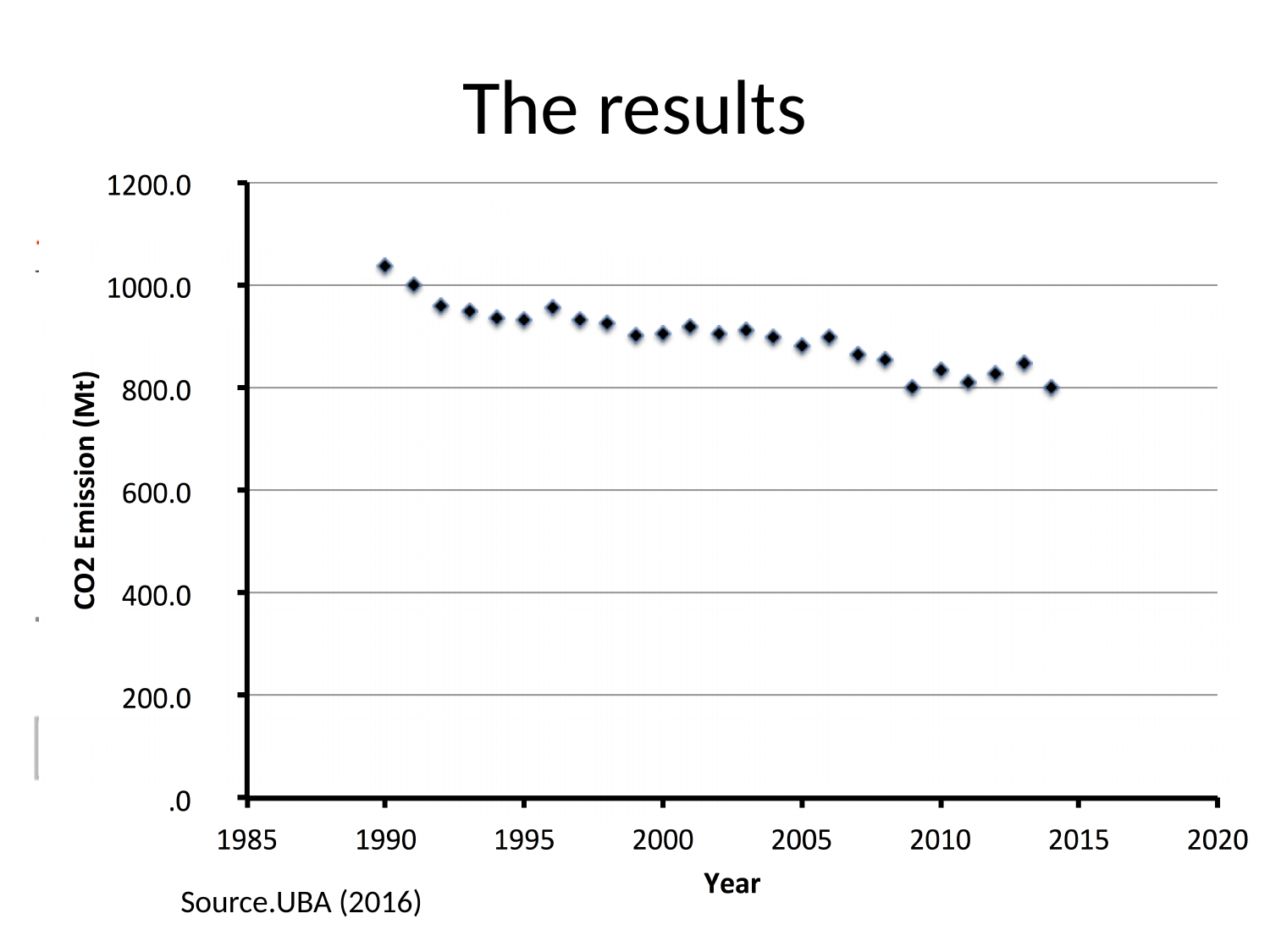
Is the CO2 emission value for 2000 greater or less than 1000? less Do the CO2 emission values generally rise or fall from 1990 to 2014? fall How many data points are plotted on the chart? 25 Is the CO2 emission value for 1990 greater or less than 1000? greater Which year has the larger CO2 emission value, 2009 or 2013? 2013 Which year has the larger CO2 emission value, 1990 or 2014? 1990 Is the CO2 emission value for 2005 greater or less than 1000? less What kind of chart is shown on the slide? scatter chart What is the label of the vertical axis? CO2 Emission (Mt) Which year has the highest CO2 emission value? 1990 What is the label of the horizontal axis? Year